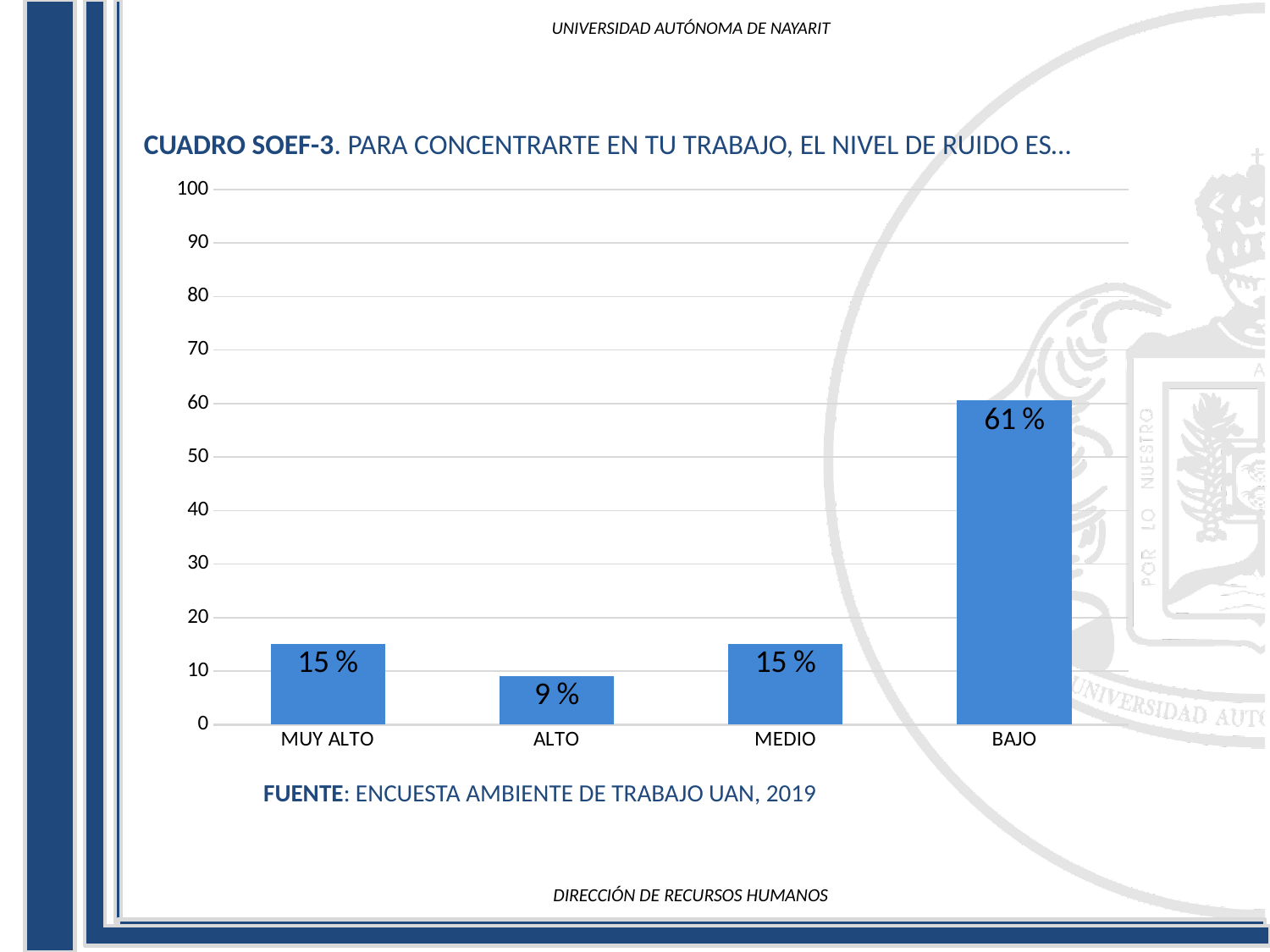
Which category has the lowest value? ALTO How many categories are shown on the x axis? 4 What is the value for BAJO? 61 % Is the value for BAJO greater or less than 50? greater Which category has the highest value? BAJO What is the title of the chart? CUADRO SOEF-3. PARA CONCENTRARTE EN TU TRABAJO, EL NIVEL DE RUIDO ES… What is the value for MUY ALTO? 15 % Which is larger, the value for ALTO or the value for MEDIO? MEDIO What is the difference between the values for BAJO and MEDIO? 46 % What kind of chart is shown on the slide? bar chart What is the value for ALTO? 9 % What source is cited below the chart? ENCUESTA AMBIENTE DE TRABAJO UAN, 2019